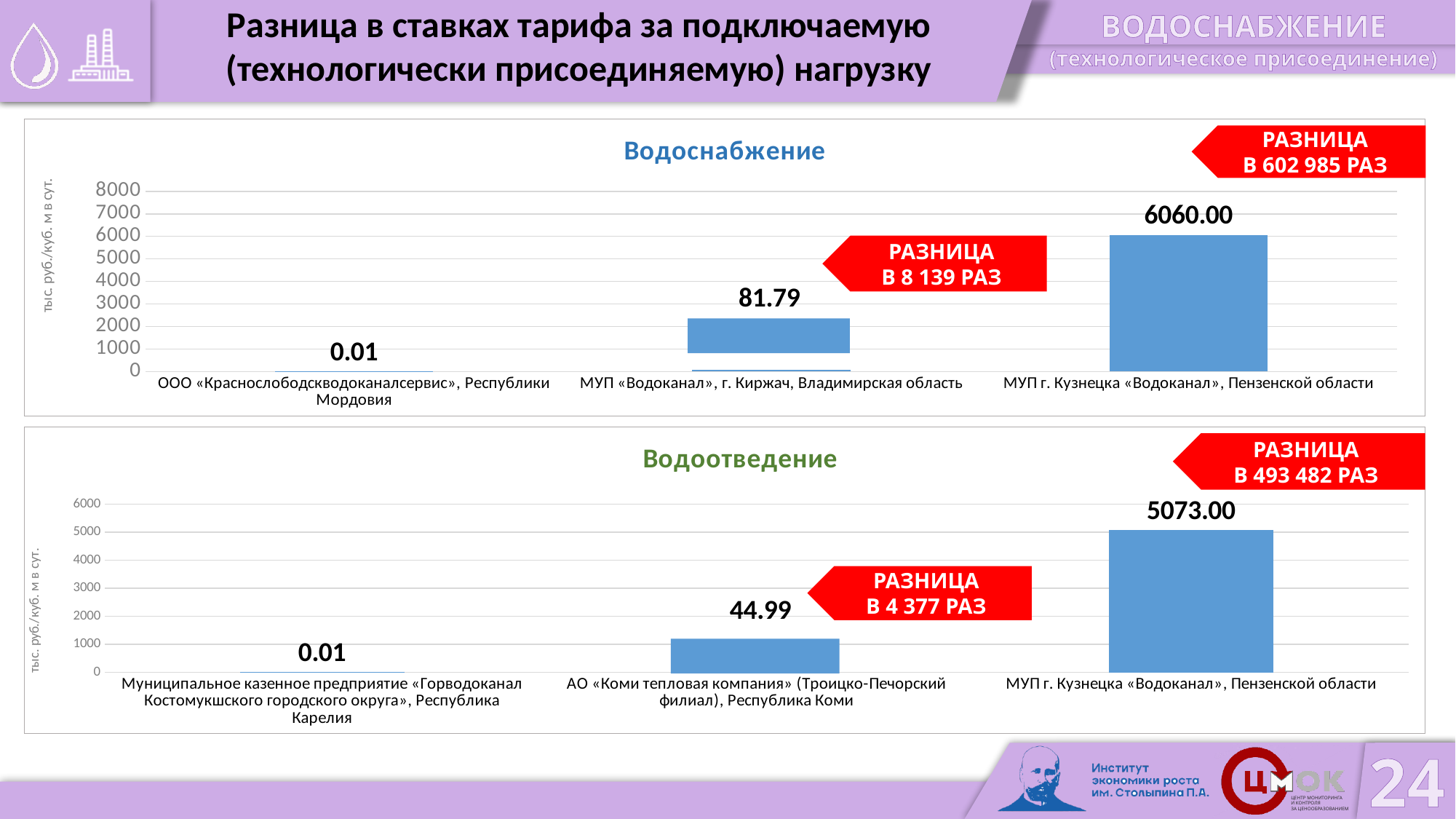
On the "Водоснабжение" chart, what is the difference between the values for МУП г. Кузнецка «Водоканал» and МУП «Водоканал», г. Киржач? 5978.21 On the "Водоснабжение" chart, what is the value for МУП г. Кузнецка «Водоканал», Пензенской области? 6060.00 On the "Водоснабжение" chart, what is the value for МУП «Водоканал», г. Киржач, Владимирская область? 81.79 On the "Водоснабжение" chart, which category has the lowest value? ООО «Краснослободскводоканалсервис», Республики Мордовия What kind of chart is the "Водоснабжение" chart? Bar chart On the "Водоотведение" chart, which is larger: the value for АО «Коми тепловая компания» or the value for Муниципальное казенное предприятие «Горводоканал Костомукшского городского округа»? АО «Коми тепловая компания» On the "Водоснабжение" chart, what is the value for ООО «Краснослободскводоканалсервис», Республики Мордовия? 0.01 On the "Водоотведение" chart, which category has the highest value? МУП г. Кузнецка «Водоканал», Пензенской области On the "Водоотведение" chart, what is the value for МУП г. Кузнецка «Водоканал», Пензенской области? 5073.00 On the "Водоотведение" chart, what is the value for АО «Коми тепловая компания» (Троицко-Печорский филиал), Республика Коми? 44.99 What is the y-axis unit label on the "Водоснабжение" chart? тыс. руб./куб. м в сут. How many categories are shown on the "Водоотведение" chart? 3